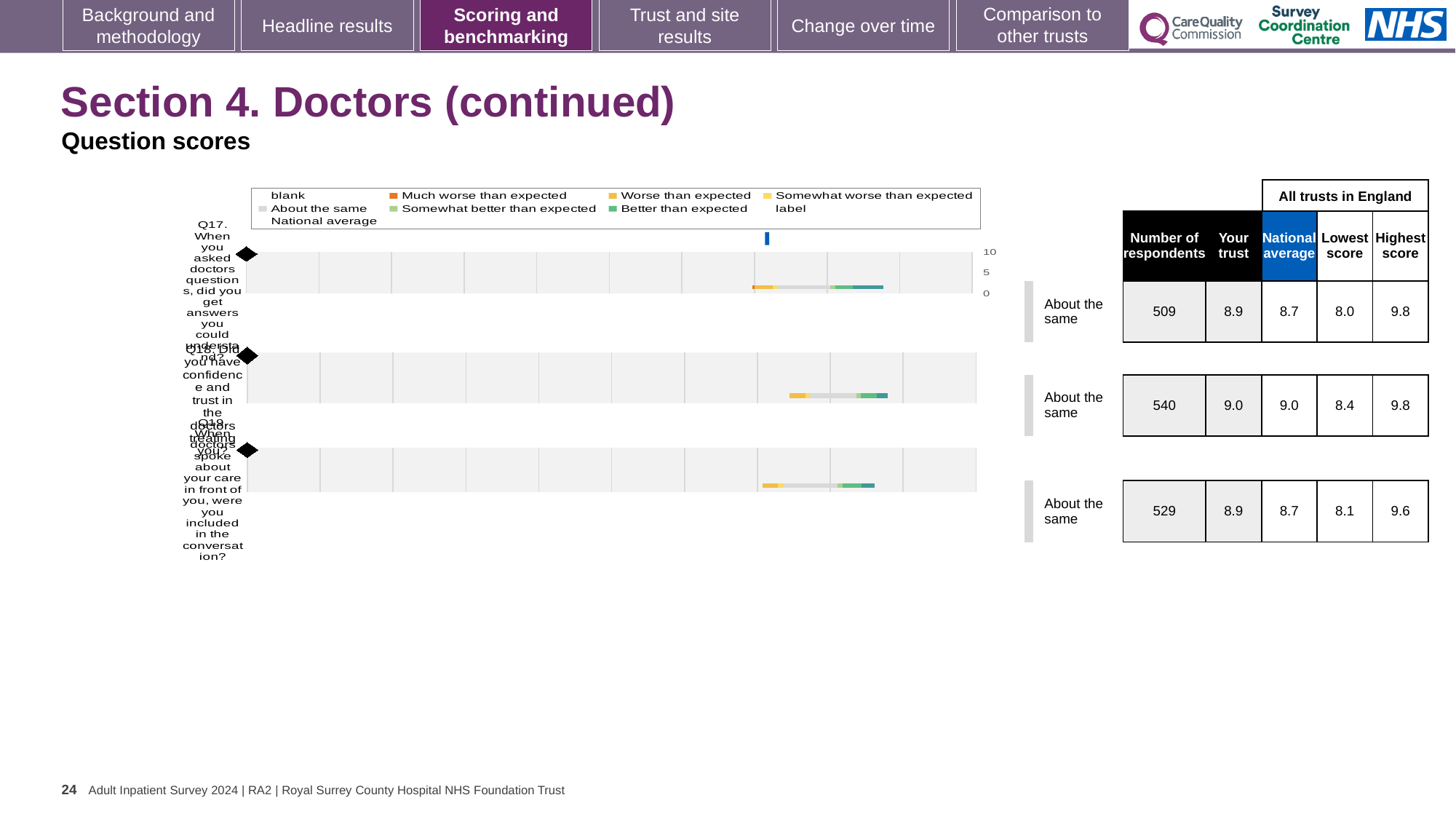
What kind of chart is used to show the Q17 score? bar chart For Q18 (confidence and trust in doctors), what is the national average score? 9.0 How many entries does the chart legend list? 9 For Q17, is the 'Your trust' score or the national average higher? Your trust For Q17 (answers you could understand), what is the 'Your trust' score? 8.9 What is the highest tick value shown on the score axis of the Q17 chart? 10 Which colour in the legend represents 'Much worse than expected'? orange Which question had the largest number of respondents? Q18 What benchmark category is shown for Q19? About the same How many questions (Q17, Q18, Q19) are plotted as separate bars on the slide? 3 For Q19, what is the difference between the highest score (9.6) and the lowest score (8.1)? 1.5 For Q19 (included in the conversation), what is the lowest score among all trusts in England? 8.1